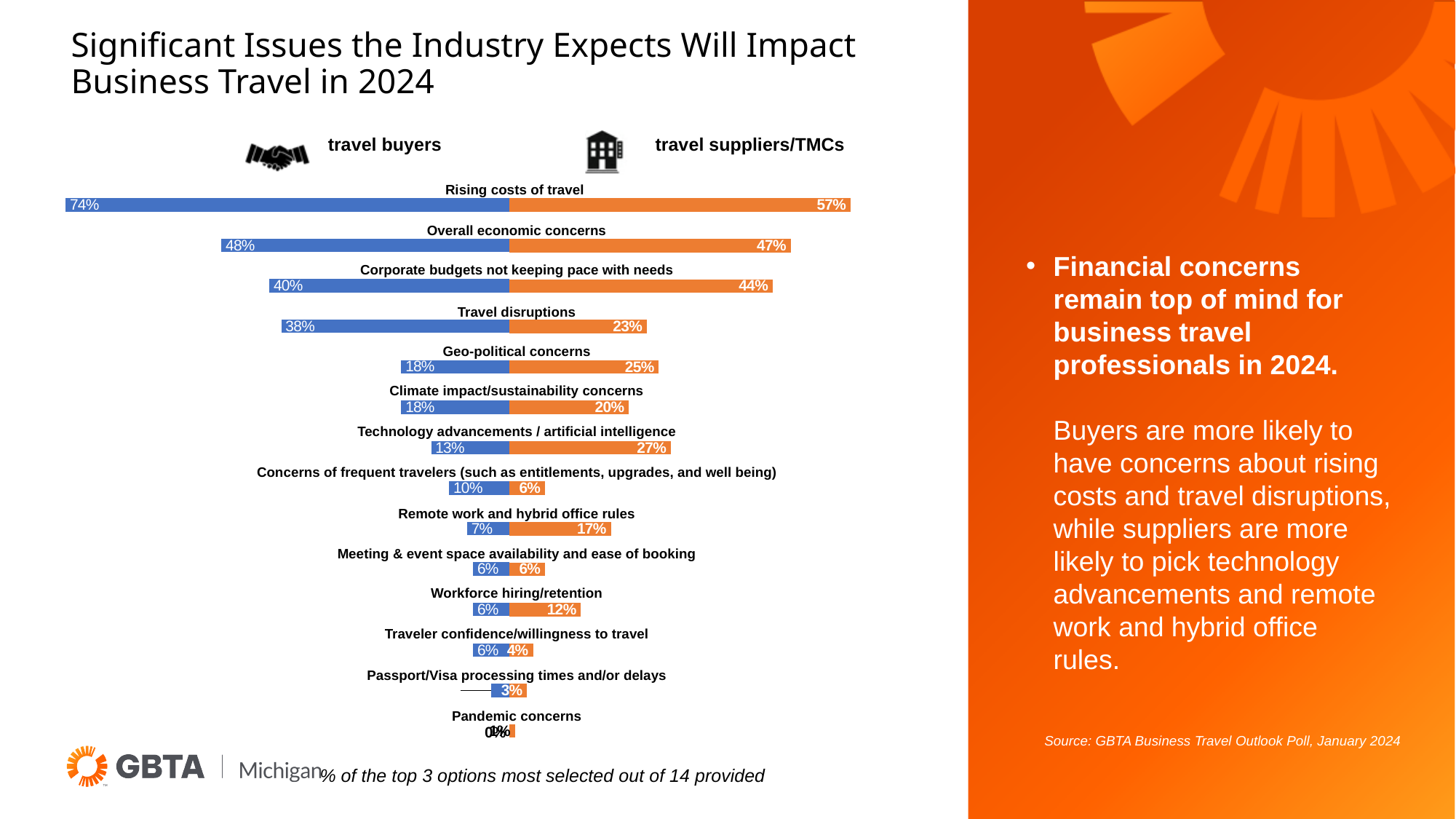
What type of chart is shown on the slide? bar chart What percentage of travel suppliers/TMCs selected Technology advancements / artificial intelligence? 27% What is the difference between travel buyers and travel suppliers/TMCs for Travel disruptions? 15% How many issues are listed in the chart? 14 What is the difference between travel buyers and travel suppliers/TMCs for Rising costs of travel? 17% Which issue has the highest percentage among travel buyers? Rising costs of travel For Workforce hiring/retention, which group has the larger percentage, travel buyers or travel suppliers/TMCs? travel suppliers/TMCs What percentage of travel suppliers/TMCs selected Remote work and hybrid office rules? 17% For Concerns of frequent travelers, which group has the larger percentage, travel buyers or travel suppliers/TMCs? travel buyers What percentage of travel buyers selected Rising costs of travel? 74% Which issue has the highest percentage among travel suppliers/TMCs? Rising costs of travel How many groups (series) does the chart compare? 2